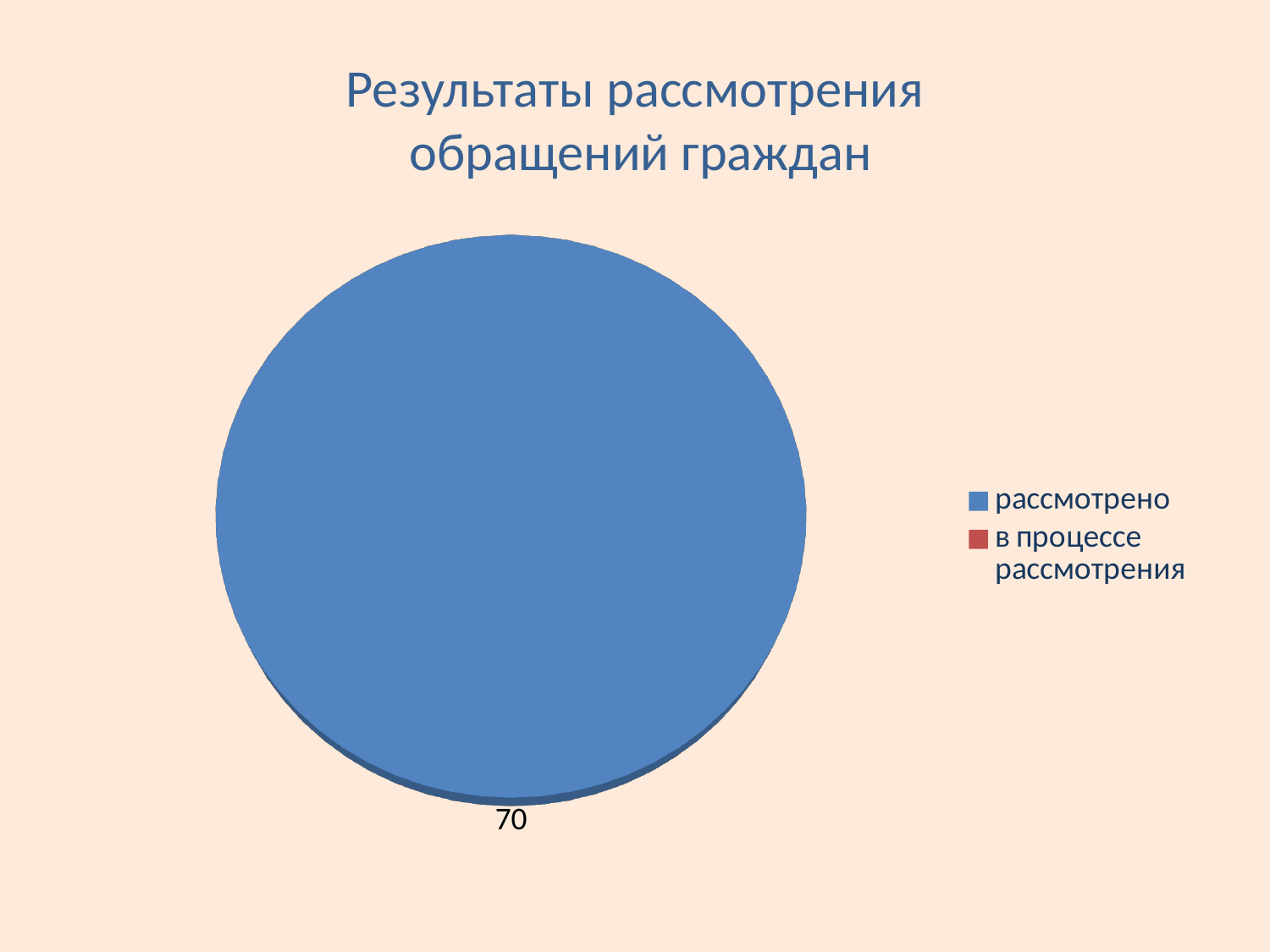
What is the title of the chart? Результаты рассмотрения обращений граждан What colour represents "рассмотрено" in the legend? blue How many entries does the legend list? 2 Is the value for "рассмотрено" greater or less than 50? greater Which category has the largest slice of the pie? рассмотрено What is the value shown for the "рассмотрено" slice? 70 What kind of chart is shown on the slide? pie chart Which is larger, "рассмотрено" or "в процессе рассмотрения"? рассмотрено